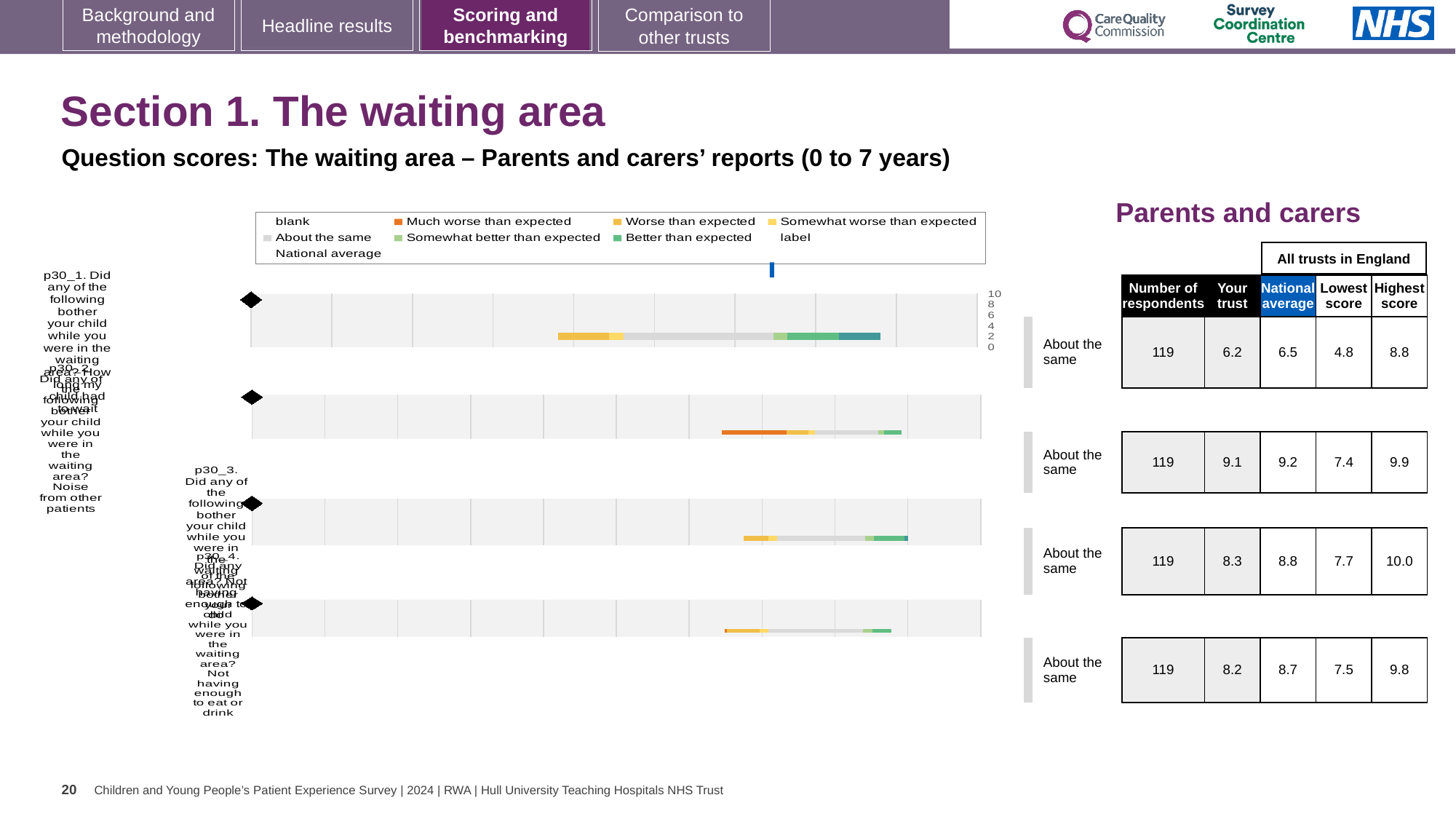
What is the difference between the highest score and the lowest score for the first row (p30_1)? 4.0 In the table, what is the highest score across all trusts in England for the third row (p30_3)? 10.0 How many questions (bars) are plotted in the chart? 4 What kind of chart is shown on the slide? bar chart How many respondents are listed for each question in the table? 119 Which row of the table has the highest 'Your trust' score? second row (p30_2) In the table, what is the lowest score across all trusts in England for the fourth row (p30_4)? 7.5 How many entries does the chart legend list? 9 In the table, what is the 'Your trust' score for the first row (p30_1)? 6.2 In the table, what is the national average for the second row (p30_2)? 9.2 Is the 'Your trust' score or the national average larger for the third row (p30_3)? national average Which row of the table has the lowest 'Your trust' score? first row (p30_1)